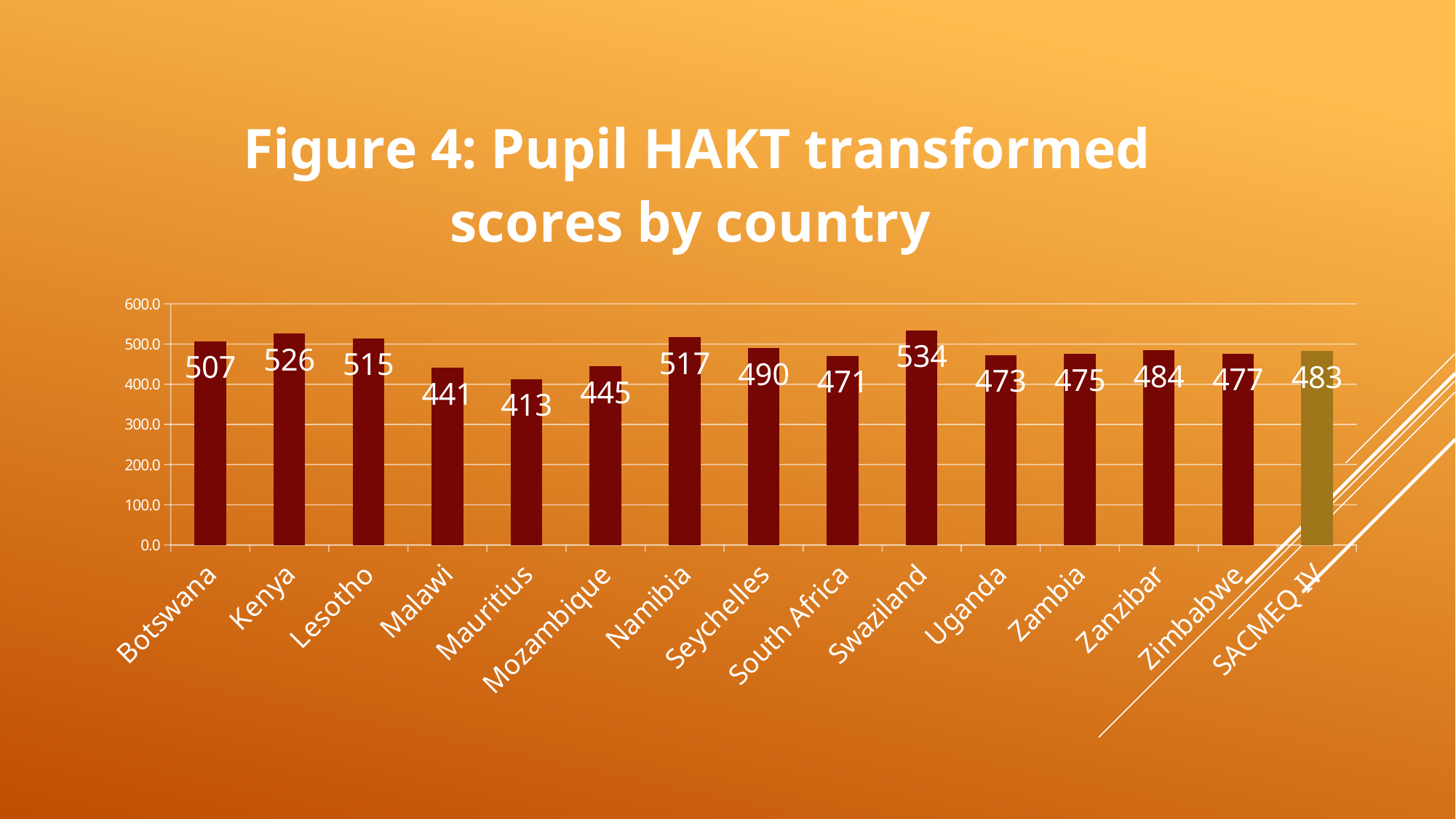
What is the difference between the scores for Kenya and Lesotho? 11 How many bars are plotted in the chart? 15 What is the pupil HAKT transformed score for Mauritius? 413 Which has a higher score, Namibia or Seychelles? Namibia Is the value for Malawi greater or less than 500? less Which country has the highest pupil HAKT transformed score? Swaziland Which country has the lowest pupil HAKT transformed score? Mauritius What type of chart is shown on the slide? Bar chart What is the difference between the scores for Swaziland and Mauritius? 121 What is the value shown for SACMEQ IV? 483 What is the pupil HAKT transformed score for Kenya? 526 What is the title of the chart? Figure 4: Pupil HAKT transformed scores by country